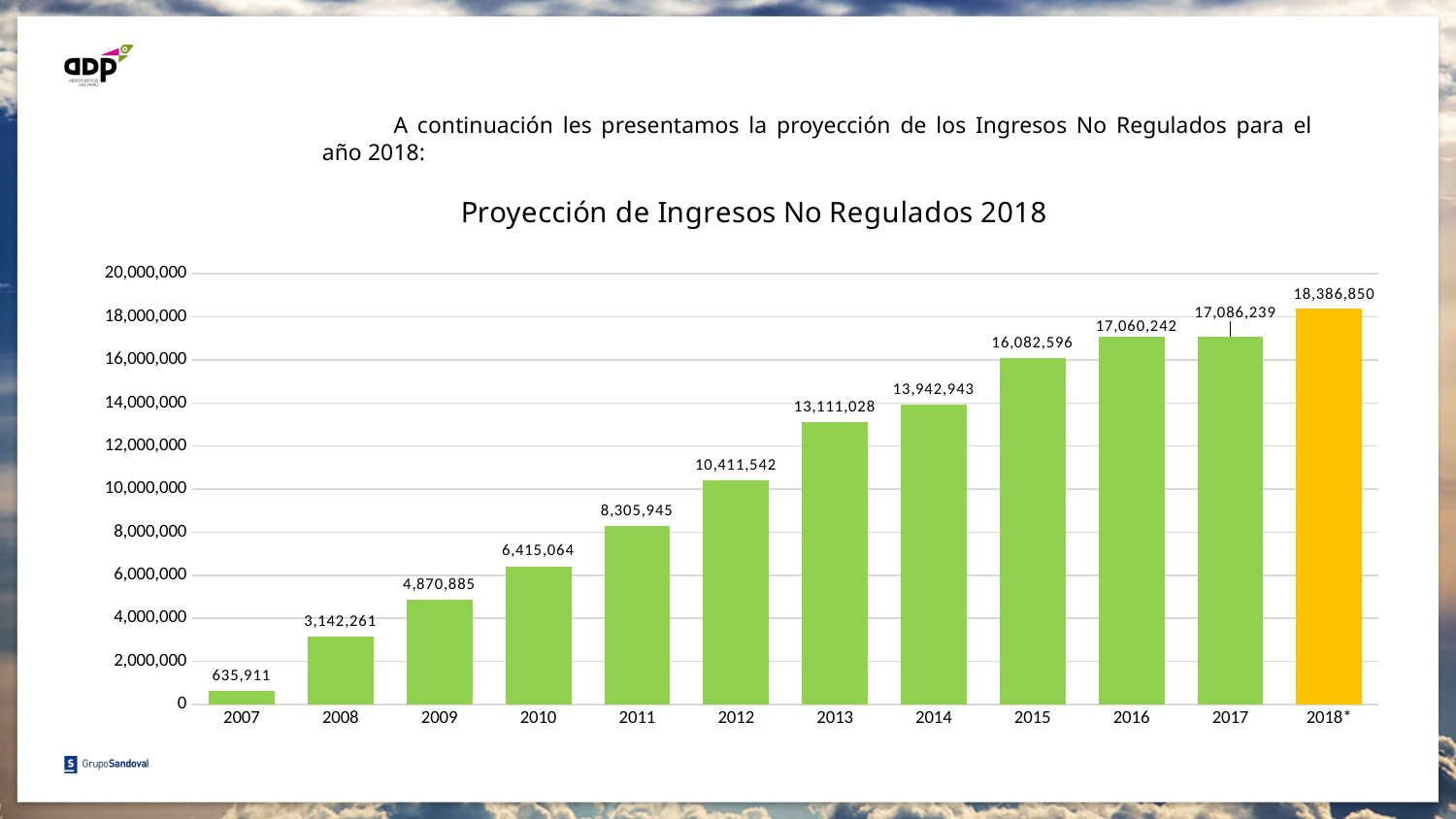
What kind of chart is shown on the slide? bar chart What is the difference between the values for 2018* and 2017? 1,300,611 What is the value for 2012 in the chart? 10,411,542 What is the value for 2015 in the chart? 16,082,596 How many years are shown on the x axis of the chart? 12 Which is larger, the value for 2012 or the value for 2013? 2013 Which year has the highest value in the chart? 2018* What is the value for 2018* in the chart? 18,386,850 Is the value for 2011 greater or less than 8,000,000? greater What is the value for 2007 in the chart? 635,911 Which year has the lowest value in the chart? 2007 What is the difference between the values for 2014 and 2013? 831,915